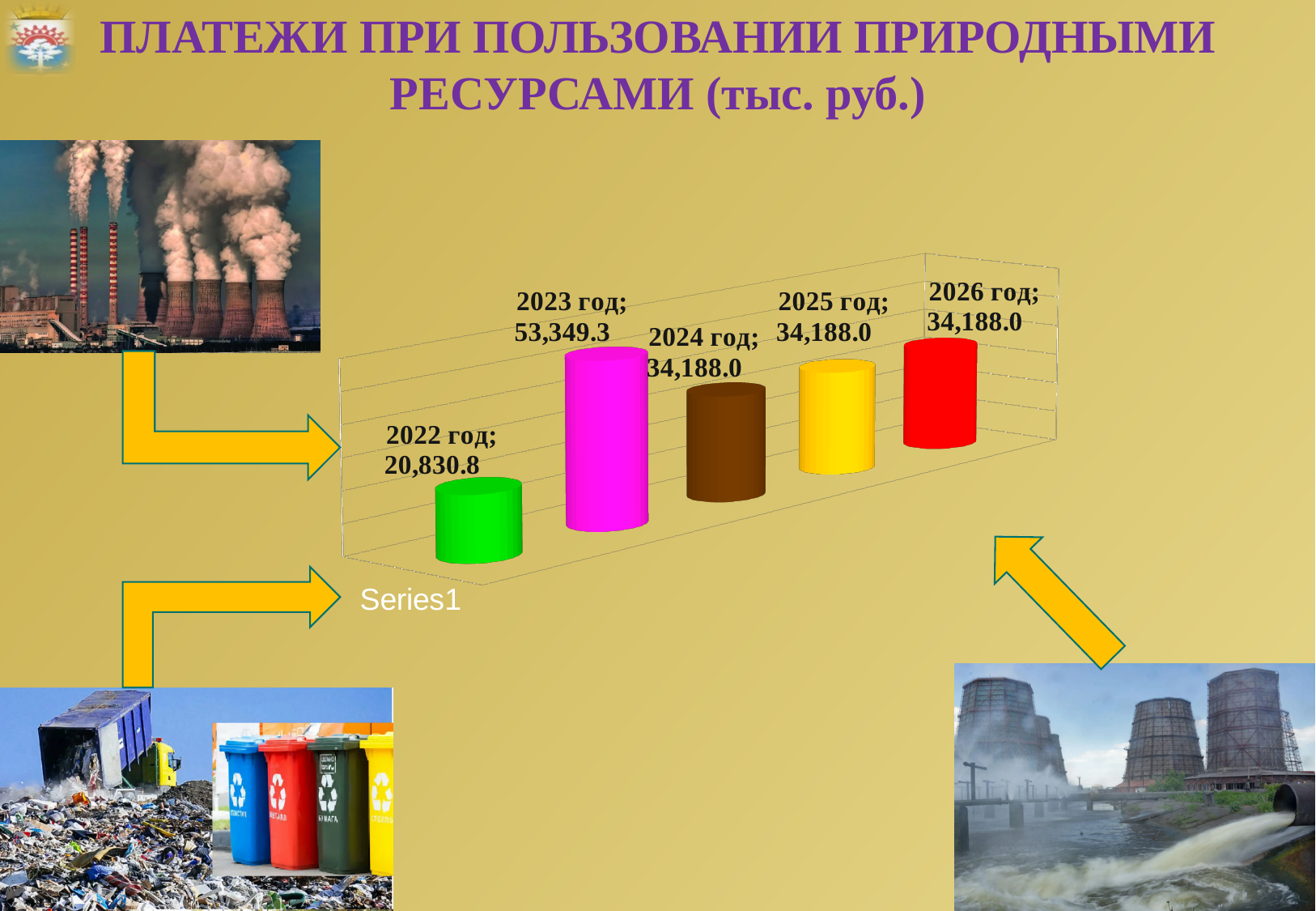
What is the difference between the values for 2023 год and 2022 год? 32,518.5 What is the difference between the values for 2023 год and 2024 год? 19,161.3 Which is larger, the value for 2024 год or the value for 2022 год? 2024 год What is the series name shown below the chart? Series1 What is the value for 2023 год? 53,349.3 What kind of chart is shown on the slide? Bar chart Which year has the highest value? 2023 год How many years are shown in the chart? 5 Do the values rise or fall from 2023 год to 2024 год? Fall What is the value for 2025 год? 34,188.0 Which year has the lowest value? 2022 год What is the value for 2022 год? 20,830.8